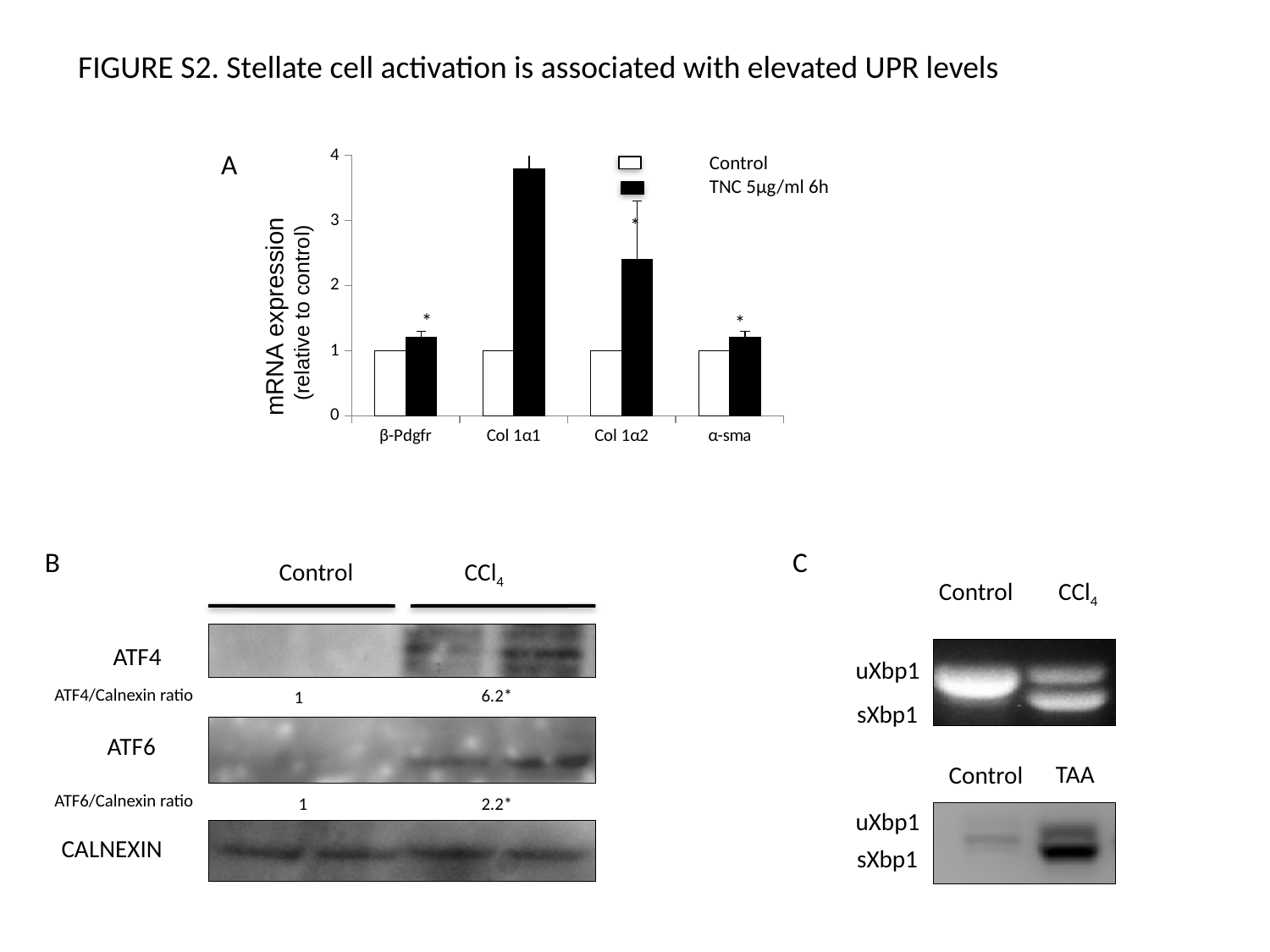
In panel A, how many series does the legend list? 2 In panel A, is the TNC 5µg/ml 6h value for β-Pdgfr greater or less than 2? less In panel A, what is the Control value for β-Pdgfr? 1 In panel A, is the TNC 5µg/ml 6h value for Col 1α2 greater or less than 2? greater In panel A, which is larger: the TNC 5µg/ml 6h bar for Col 1α1 or for Col 1α2? Col 1α1 In panel A, is the TNC 5µg/ml 6h value for α-sma greater or less than 1? greater What kind of chart is panel A? bar chart In panel A, how many gene categories are shown on the x axis? 4 In panel A, which category has the highest TNC 5µg/ml 6h bar? Col 1α1 In panel A, what is the y-axis label? mRNA expression (relative to control) In panel A, what are the two legend entries? Control and TNC 5µg/ml 6h